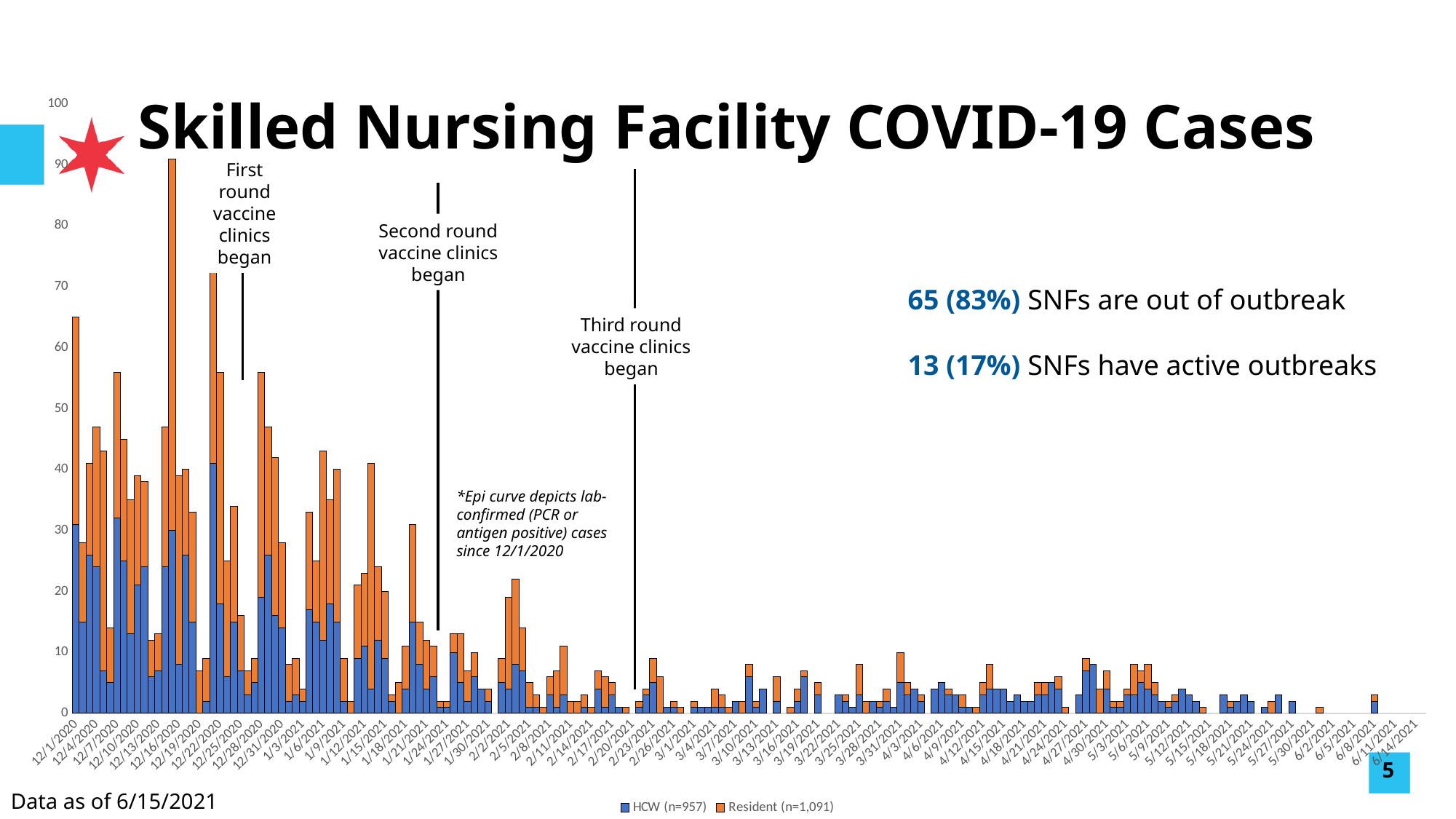
How many series does the chart legend list? 2 How many rounds of vaccine clinics are marked on the chart? 3 Is the total for 3/1/2021 greater or less than 10? less Which colour represents the Resident series in the chart? Orange What are the two series named in the chart legend? HCW (n=957) and Resident (n=1,091) Which series is plotted at the bottom of each stacked bar, HCW or Resident? HCW Is the total for 12/1/2020 greater or less than 50? greater What kind of chart is shown on the slide? Stacked bar chart Is the tallest bar on the chart greater or less than 80? greater Which series has the larger total n according to the legend, HCW or Resident? Resident Do the daily case counts generally rise or fall from December 2020 to June 2021? Fall